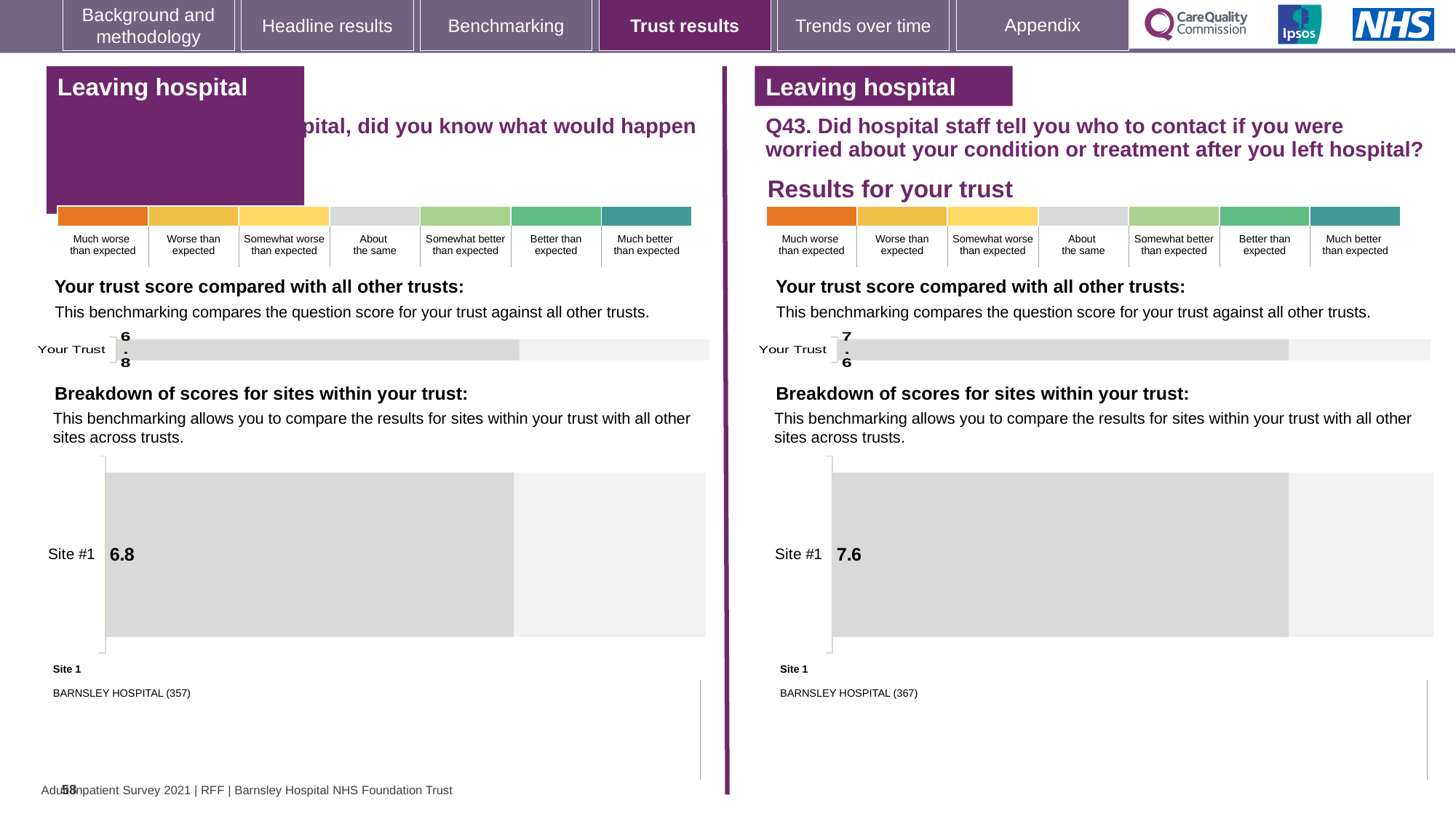
How many sites are plotted in the Q43 'Breakdown of scores for sites within your trust' chart on the right? 1 In the Q43 breakdown chart on the right, which hospital does Site 1 refer to? BARNSLEY HOSPITAL (367) What type of chart is used to show the Site #1 score in the Q43 breakdown chart on the right? Bar chart In the breakdown chart on the left half of the slide, which hospital does Site 1 refer to? BARNSLEY HOSPITAL (357) How many categories are plotted in the 'Your trust score compared with all other trusts' chart on the left half of the slide? 1 In the Q43 'Breakdown of scores for sites within your trust' chart on the right, what is the score for Site #1? 7.6 In the Q43 'Your trust score compared with all other trusts' chart on the right, what is the score for Your Trust? 7.6 On the left half of the slide, what is the score shown for Site #1 in the 'Breakdown of scores for sites within your trust' chart? 6.8 Is the Your Trust score in the Q43 chart on the right greater or less than the Your Trust score in the chart on the left? greater What is the difference between the Site #1 score in the Q43 breakdown chart on the right and the Site #1 score in the breakdown chart on the left? 0.8 On the left half of the slide, what is the score shown for Your Trust in the 'Your trust score compared with all other trusts' chart? 6.8 Which is larger: the Site #1 score in the left-hand breakdown chart or the Site #1 score in the right-hand Q43 breakdown chart? Right-hand Q43 chart (7.6)